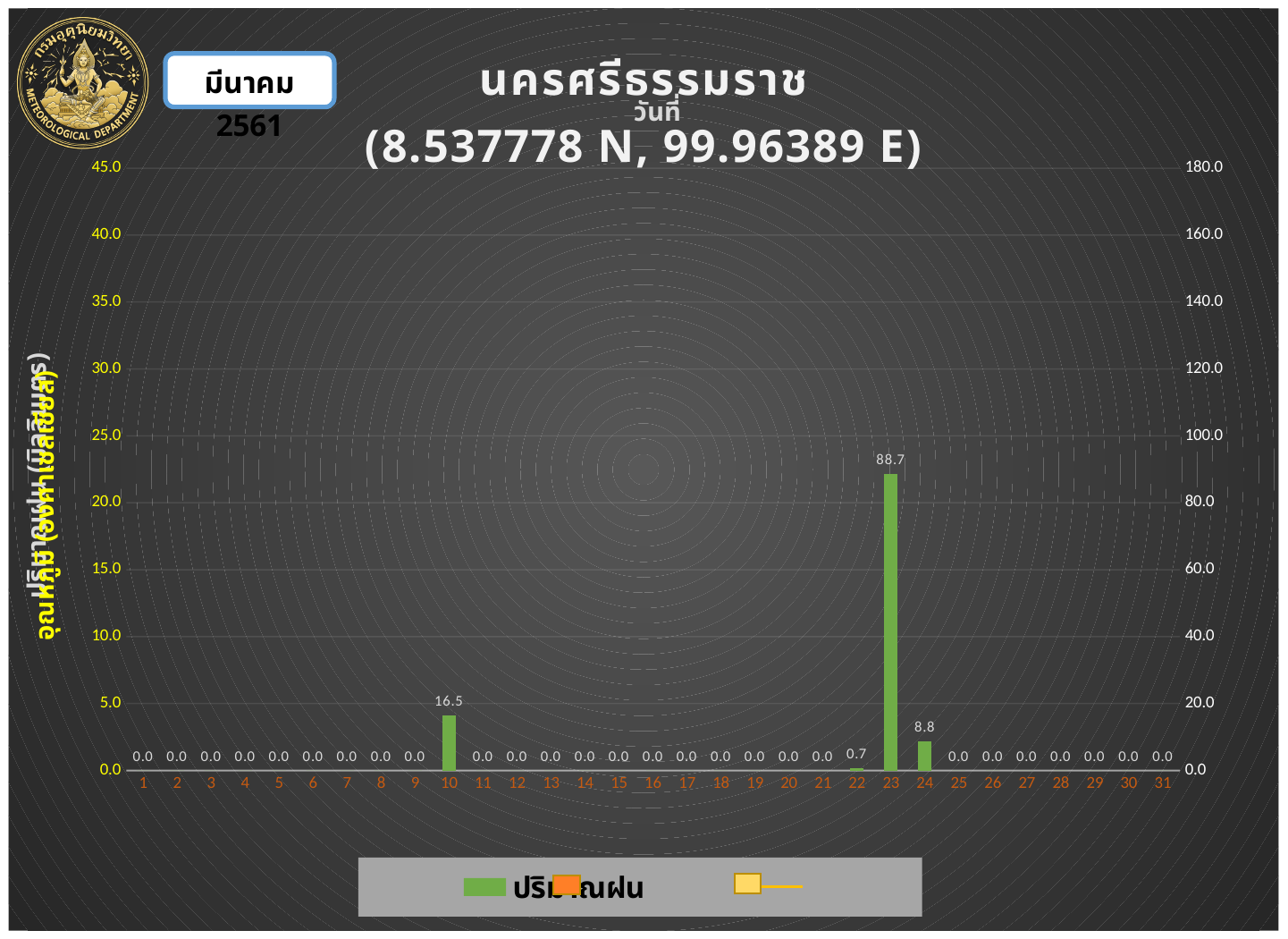
What is the difference between the rainfall values for day 23 and day 10? 72.2 What is the rainfall value shown for day 5? 0.0 What is the rainfall value shown for day 22? 0.7 What is the rainfall value shown for day 10? 16.5 What is the rainfall value shown for day 24? 8.8 What is the difference between the rainfall values for day 10 and day 24? 7.7 What kind of chart is shown on the slide? bar chart Which day has the highest rainfall value? 23 How many days (categories) are shown on the x axis? 31 What is the rainfall value shown for day 23? 88.7 Which is larger, the rainfall value for day 10 or for day 24? day 10 What is the highest value shown on the right-hand vertical axis? 180.0